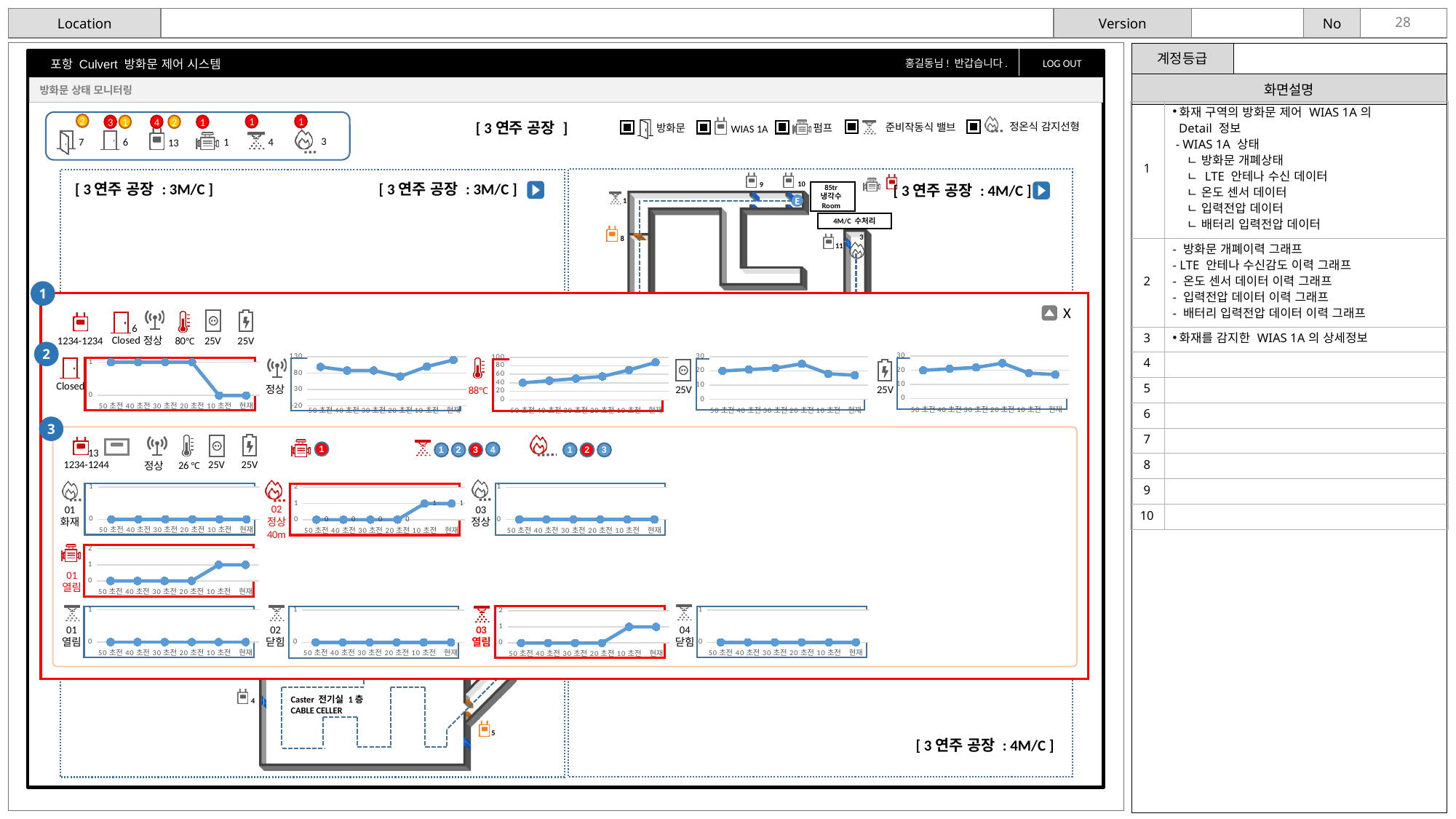
In the temperature chart labelled 88℃ in section 2, is the value at 50 초전 greater or less than 60? less In the chart labelled "03 열림" in section 3, is the value at 현재 greater or less than the value at 50 초전? greater How many time points are plotted on the x axis of the "Closed" chart in section 2? 6 In the "Closed" chart in section 2, what is the value at 50 초전? 1 What is the last x-axis label on the charts in section 3? 현재 In the temperature chart labelled 88℃ in section 2, do the values rise or fall from 50 초전 to 현재? rise In the "Closed" chart in section 2, what is the value at 현재? 0 In the chart labelled "02 정상 40m" in section 3, what is the value at 50 초전? 0 In the chart labelled "02 정상 40m" in section 3, what is the value at 현재? 1 What kind of chart is the chart labelled "Closed" in the row of charts in section 2? line chart In the temperature chart labelled 88℃ in section 2, is the value at 현재 greater or less than 80? greater In the LTE chart labelled 정상 in section 2, is the value at 현재 greater or less than 80? greater